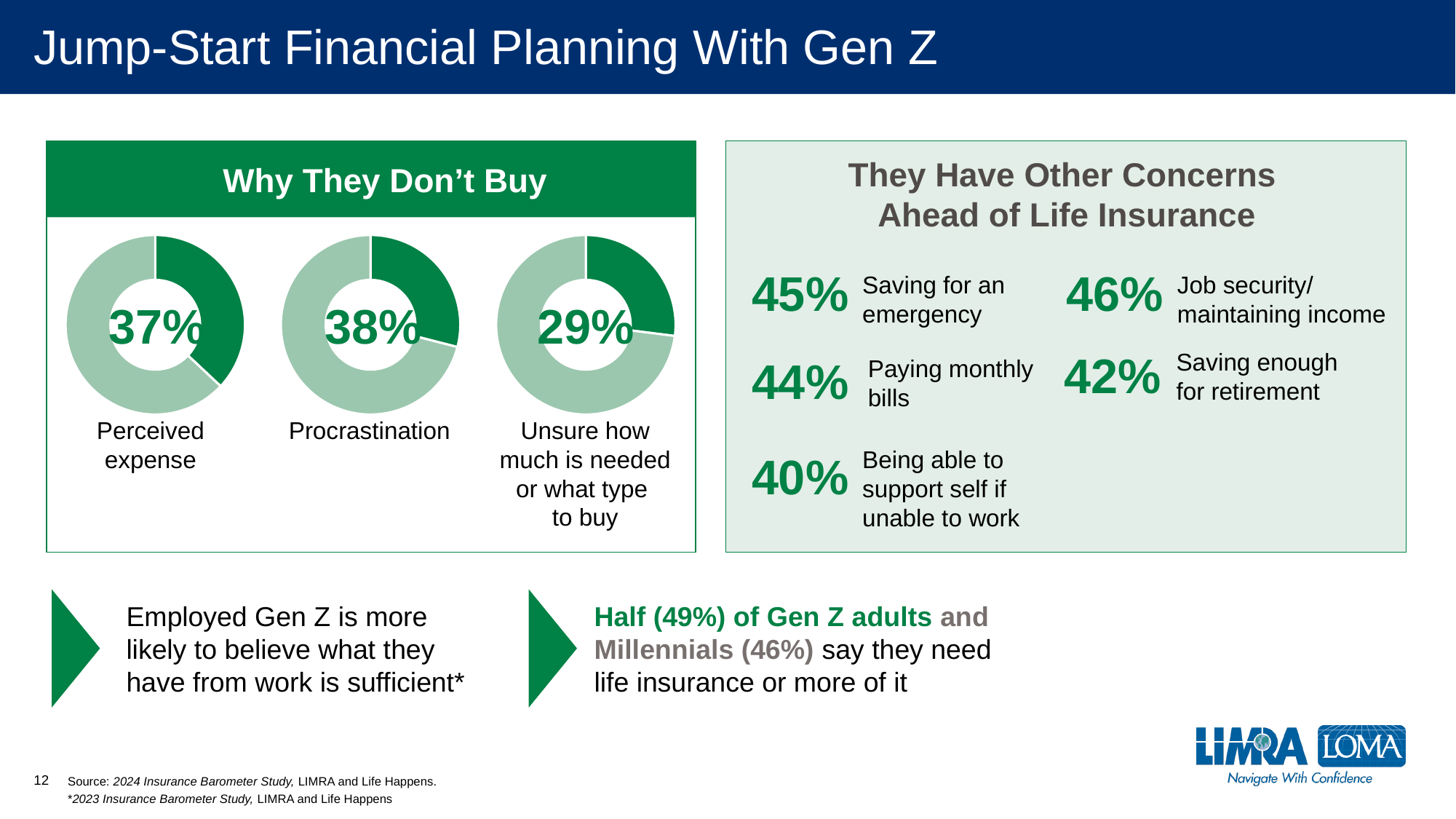
In the 'Why They Don't Buy' charts, what percentage is shown for 'Unsure how much is needed or what type to buy'? 29% In the 'Why They Don't Buy' charts, what percentage is shown for Perceived expense? 37% In the 'Why They Don't Buy' donut charts, what colour is the segment representing the stated percentage? Dark green What type of chart is used in the 'Why They Don't Buy' panel? Donut chart In the 'Why They Don't Buy' charts, what is the difference between the Procrastination percentage and the Perceived expense percentage? 1% In the 'Why They Don't Buy' charts, what percentage is shown for Procrastination? 38% In the 'Why They Don't Buy' charts, which is larger: the percentage for Perceived expense or for 'Unsure how much is needed or what type to buy'? Perceived expense In the 'Why They Don't Buy' charts, what is the difference between the Perceived expense percentage and the 'Unsure how much is needed' percentage? 8% Among the three 'Why They Don't Buy' charts, which reason has the lowest percentage? Unsure how much is needed or what type to buy How many donut charts are shown in the 'Why They Don't Buy' panel? 3 What is the title of the panel containing the three donut charts? Why They Don't Buy Among the three 'Why They Don't Buy' charts, which reason has the highest percentage? Procrastination